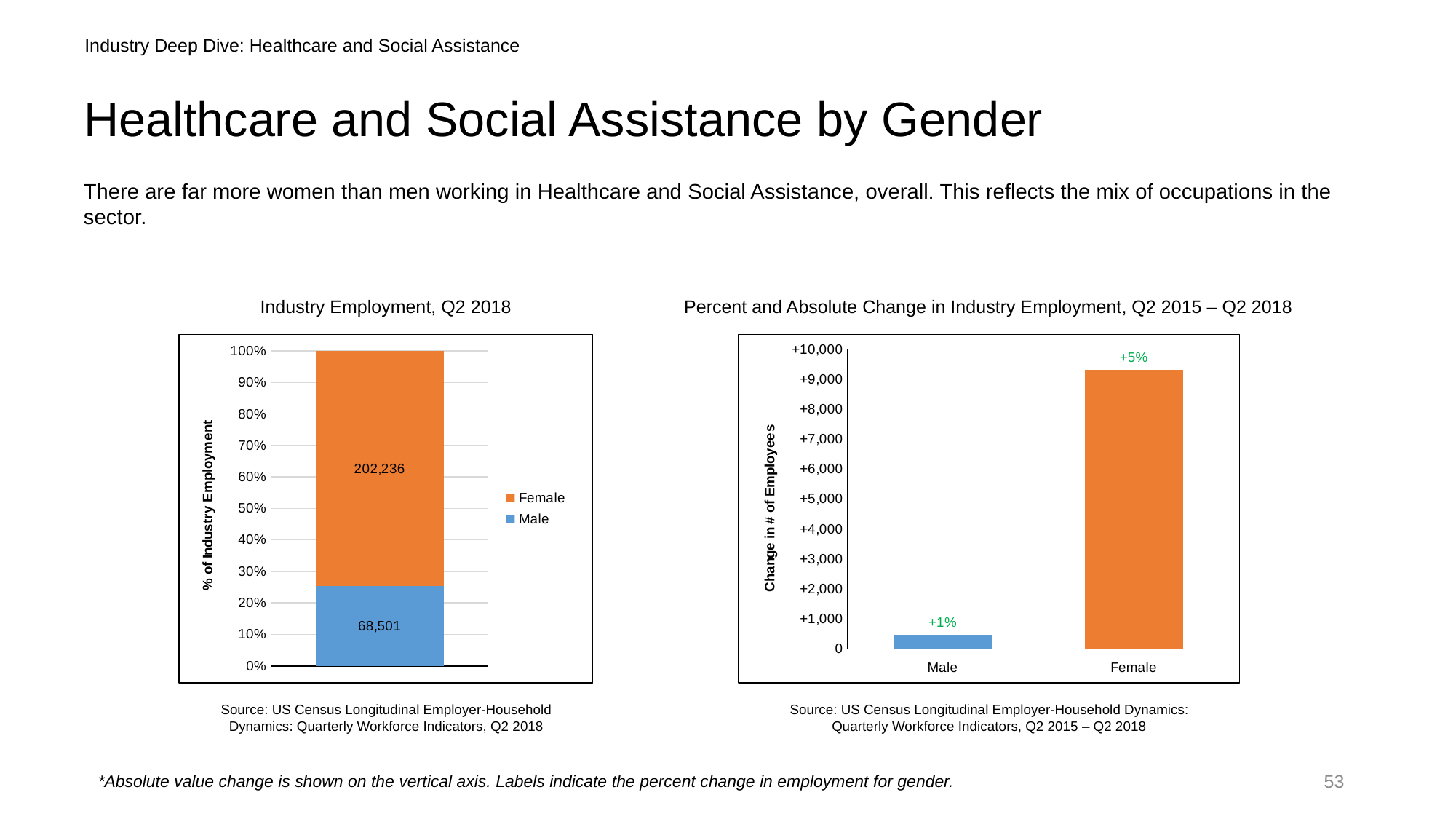
In the 'Industry Employment, Q2 2018' chart, what is the total of the stacked bar? 270,737 In the 'Percent and Absolute Change in Industry Employment, Q2 2015 – Q2 2018' chart, which category has the highest change in number of employees? Female In the 'Industry Employment, Q2 2018' chart, what colour represents Male? Blue In the 'Industry Employment, Q2 2018' chart, what is the difference between the Female and Male values? 133,735 In the 'Industry Employment, Q2 2018' chart, which group has the larger value, Female or Male? Female In the 'Percent and Absolute Change in Industry Employment, Q2 2015 – Q2 2018' chart, what percent change label is shown for Male? +1% In the 'Percent and Absolute Change in Industry Employment, Q2 2015 – Q2 2018' chart, what percent change label is shown for Female? +5% In the 'Industry Employment, Q2 2018' chart, what is the value shown for Female? 202,236 In the 'Industry Employment, Q2 2018' chart, what is the value shown for Male? 68,501 In the 'Percent and Absolute Change in Industry Employment, Q2 2015 – Q2 2018' chart, is the change in number of employees for Male greater or less than +1,000? less In the 'Industry Employment, Q2 2018' chart, how many series does the legend list? 2 In the 'Percent and Absolute Change in Industry Employment, Q2 2015 – Q2 2018' chart, is the change in number of employees for Female greater or less than +9,000? greater